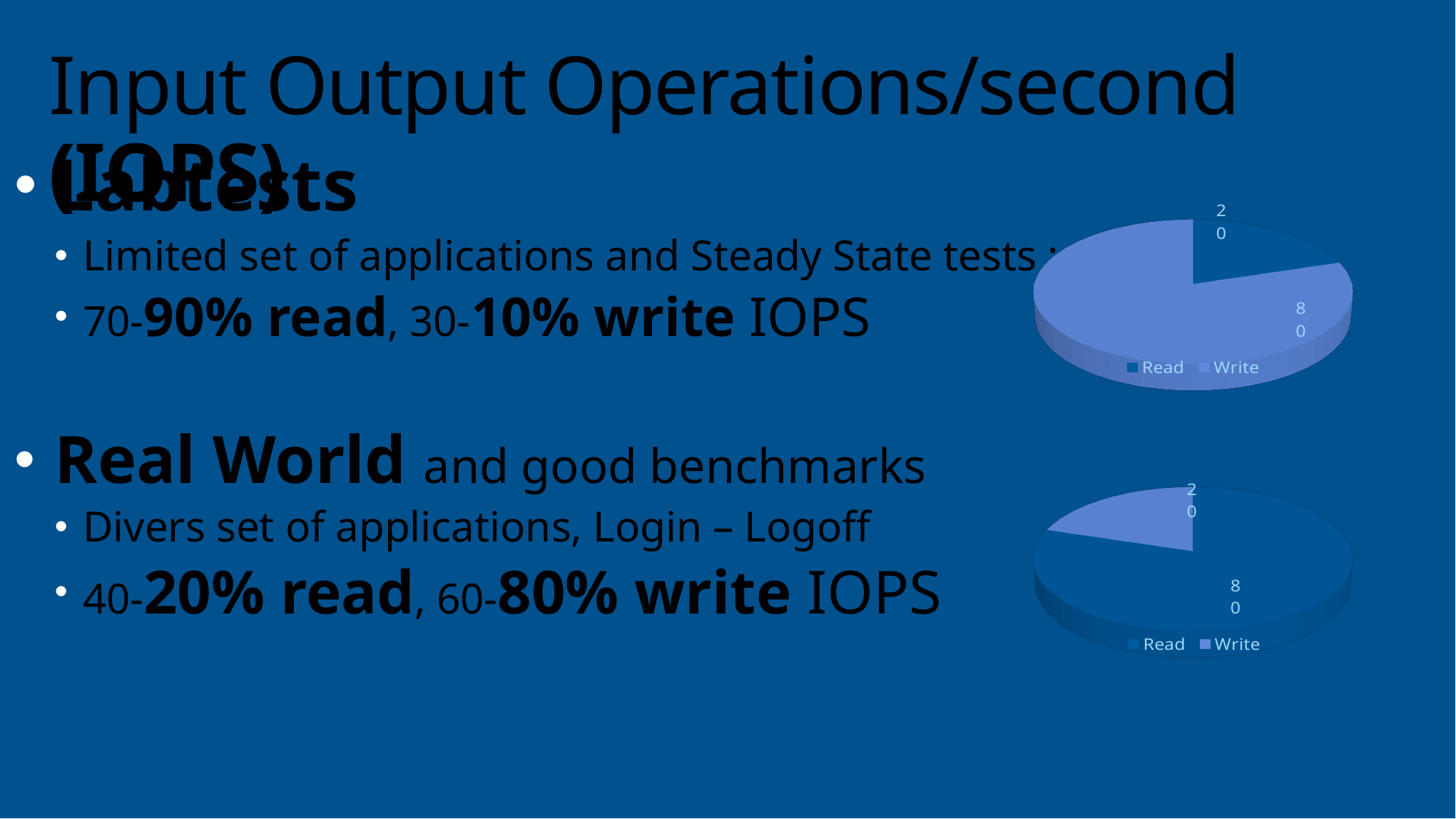
What kind of chart is the lower chart on the right of the slide? pie chart In the upper pie chart, which slice is the largest? Write How many slices does the lower pie chart have? 2 In the lower pie chart, what is the value of the Read slice? 80 In the lower pie chart, what is the value of the Write slice? 20 In the upper pie chart, what is the difference between the Write and Read values? 60 How many entries does the legend of the upper pie chart list? 2 In the lower pie chart, which slice is the smallest? Write In the upper pie chart, what is the value of the Write slice? 80 What kind of chart is the upper chart on the right of the slide? pie chart In the lower pie chart, is the Read value larger or smaller than the Write value? larger In the upper pie chart, what is the value of the Read slice? 20